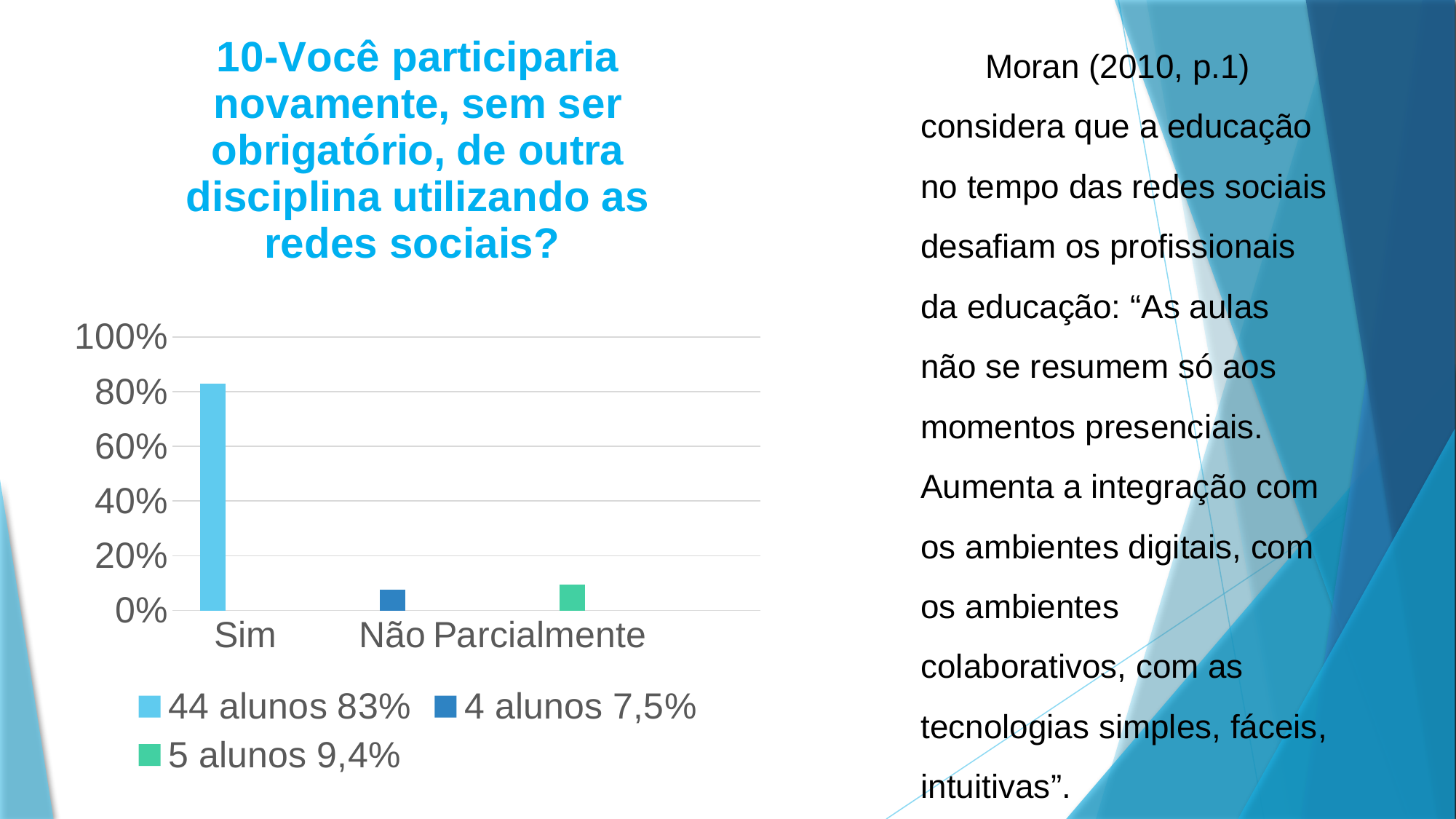
What is the legend entry for the green series? 5 alunos 9,4% What is the legend entry for the light blue series? 44 alunos 83% Which bar is taller, Sim or Não? Sim Which bar is taller, Não or Parcialmente? Parcialmente How many series does the chart's legend list? 3 Is the value for Não greater or less than 20%? less Which category has the highest bar in the chart? Sim What kind of chart is shown on the slide? bar chart Is the value for Sim greater or less than 60%? greater How many categories are shown on the x axis of the chart? 3 Is the value for Parcialmente greater or less than 20%? less